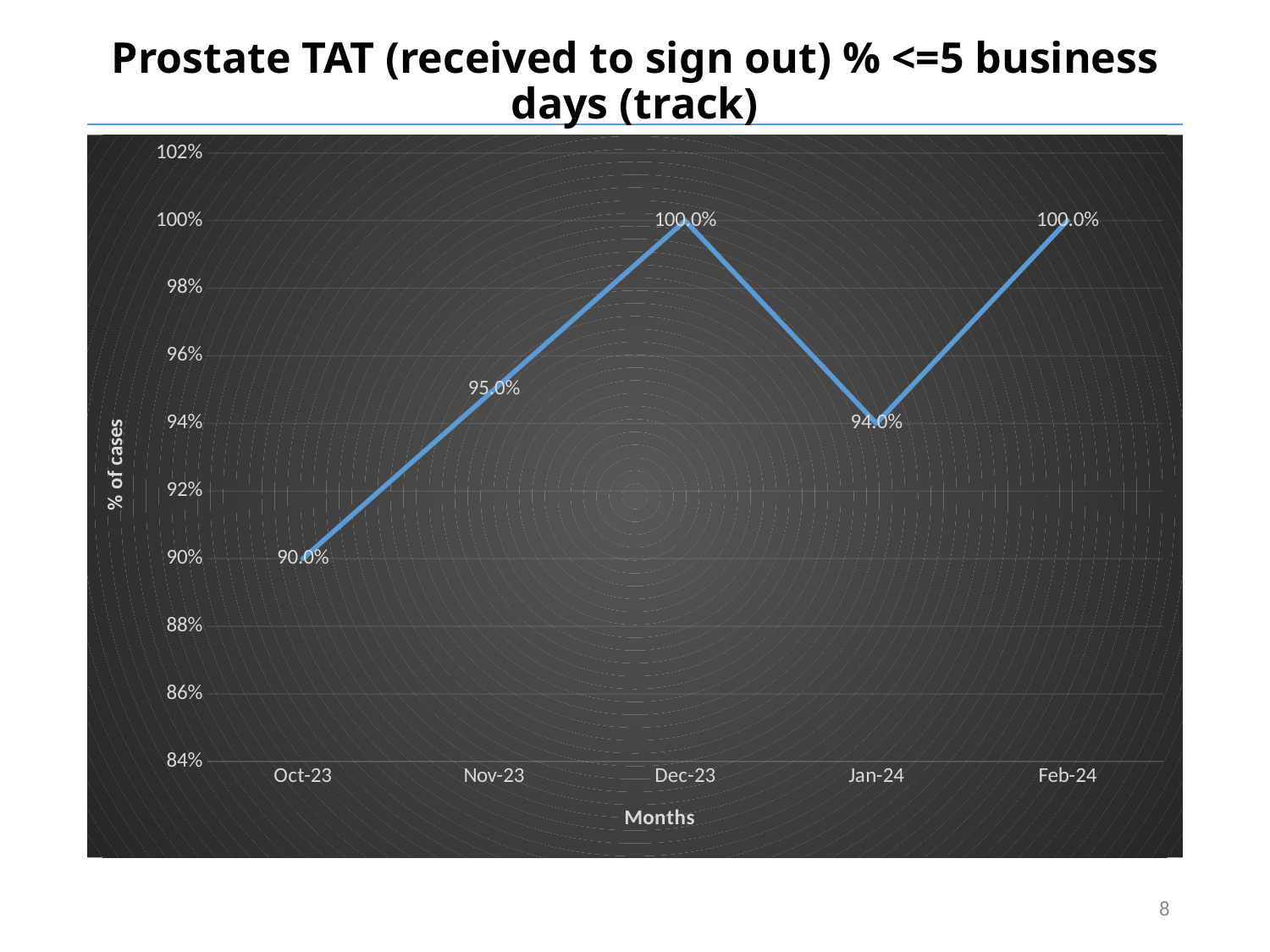
Which is larger, the value for Nov-23 or the value for Jan-24? Nov-23 What is the value for Nov-23? 95.0% What is the difference between the values for Nov-23 and Oct-23? 5.0% Is the value for Jan-24 greater or less than 96%? less What is the label of the y axis? % of cases How many months are plotted on the x axis? 5 What is the value for Dec-23? 100.0% Which month has the lowest value? Oct-23 What is the difference between the values for Dec-23 and Jan-24? 6.0% What is the value for Jan-24? 94.0% What is the value for Oct-23? 90.0% What kind of chart is shown on the slide? line chart